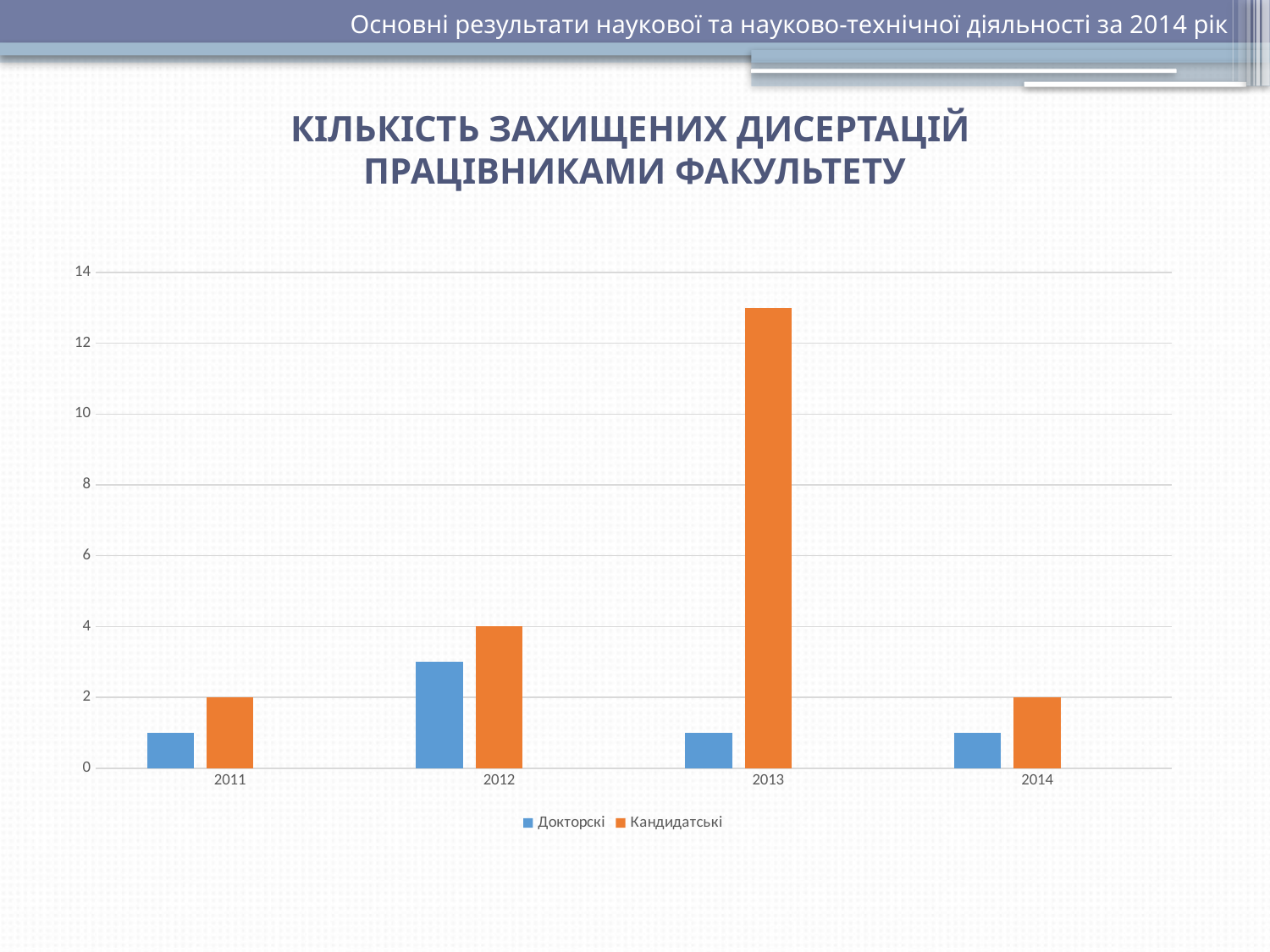
In which year is the Докторскі value highest? 2012 How many series does the legend list? 2 Is the value for Кандидатські in 2013 greater or less than 12? greater What is the value for Кандидатські in 2011? 2 What is the difference between the Кандидатські values for 2012 and 2011? 2 Is the value for Докторскі in 2012 greater or less than 2? greater What type of chart is shown on the slide? bar chart In which year is the Кандидатські value highest? 2013 What is the value for Кандидатські in 2014? 2 How many years are shown on the x axis? 4 What is the value for Кандидатські in 2012? 4 In 2013, which series has the larger value, Докторскі or Кандидатські? Кандидатські